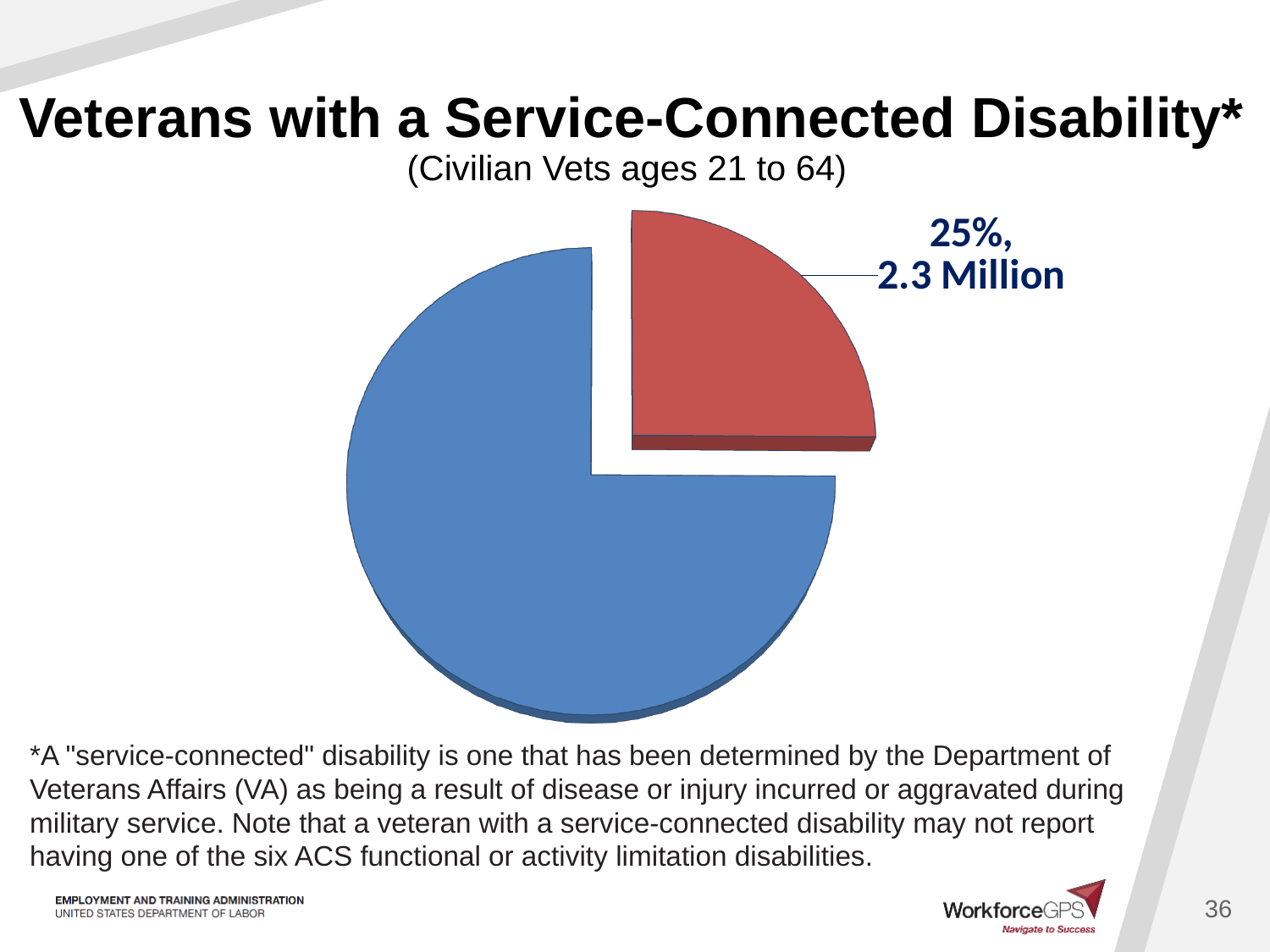
Is the red slice's share of the pie chart greater or less than 50%? less What kind of chart is shown on the slide? pie chart Which slice of the pie chart is the smallest? the red slice How many slices does the pie chart have? 2 What percentage is shown for the red slice of the pie chart? 25% Which slice of the pie chart is the largest? the blue slice What age range of civilian veterans does the chart's subtitle say it covers? 21 to 64 What number of veterans is labelled on the red slice of the pie chart? 2.3 Million What is the title of the chart on the slide? Veterans with a Service-Connected Disability* Which slice of the pie chart is larger, the blue slice or the red slice? blue